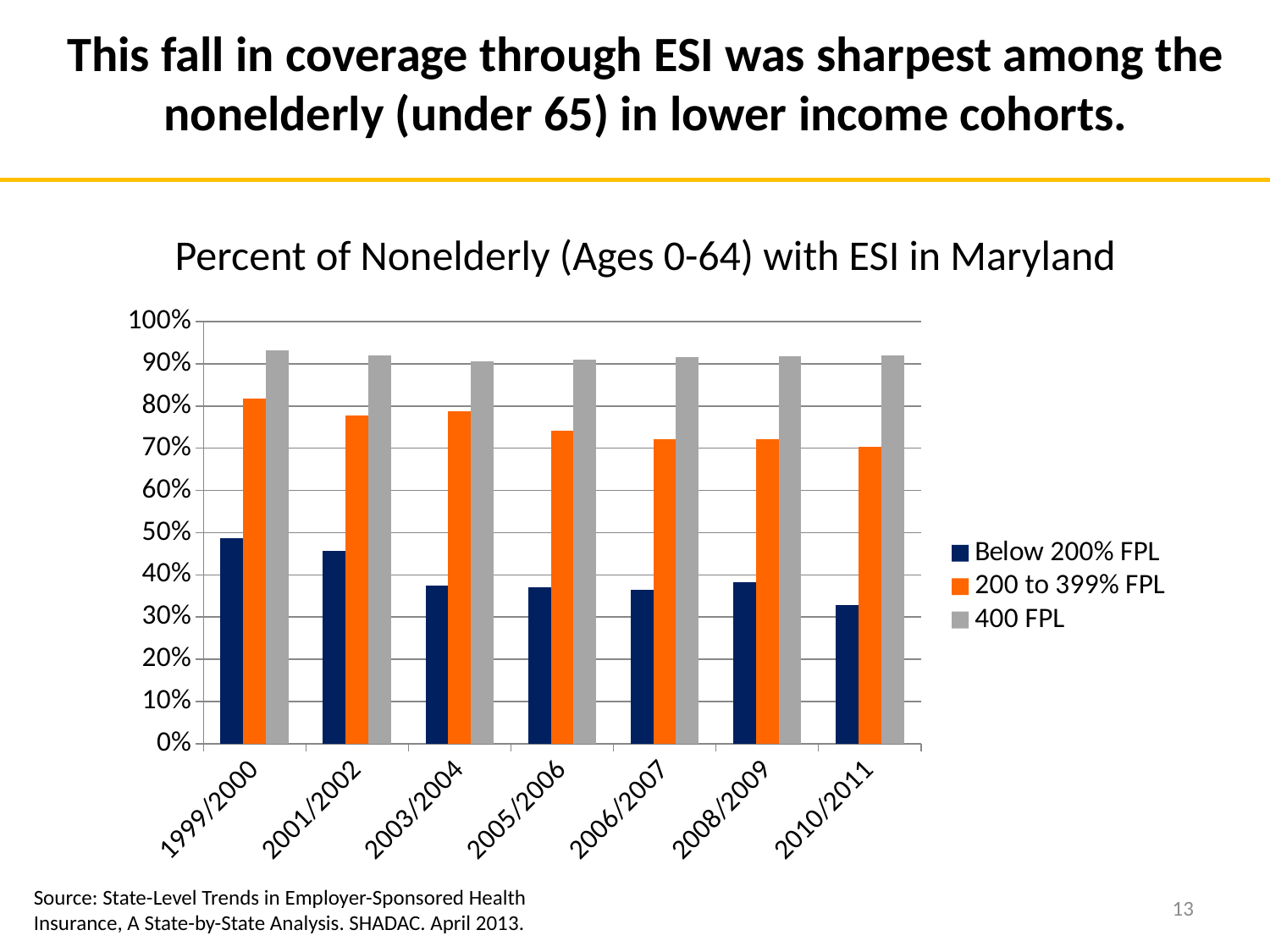
In which period is the value for 200 to 399% FPL highest? 1999/2000 Is the value for 400 FPL in 1999/2000 greater or less than 90%? greater Does the value for Below 200% FPL generally rise or fall from 1999/2000 to 2010/2011? fall How many series does the legend list? 3 Is the value for 200 to 399% FPL in 1999/2000 greater or less than 80%? greater What is the title of the chart? Percent of Nonelderly (Ages 0-64) with ESI in Maryland What kind of chart is shown on the slide? bar chart Is the value for Below 200% FPL in 2010/2011 greater or less than 40%? less Which series is shown in orange in the legend? 200 to 399% FPL How many time periods are shown on the x axis? 7 In which period is the value for Below 200% FPL lowest? 2010/2011 In which period is the value for Below 200% FPL highest? 1999/2000